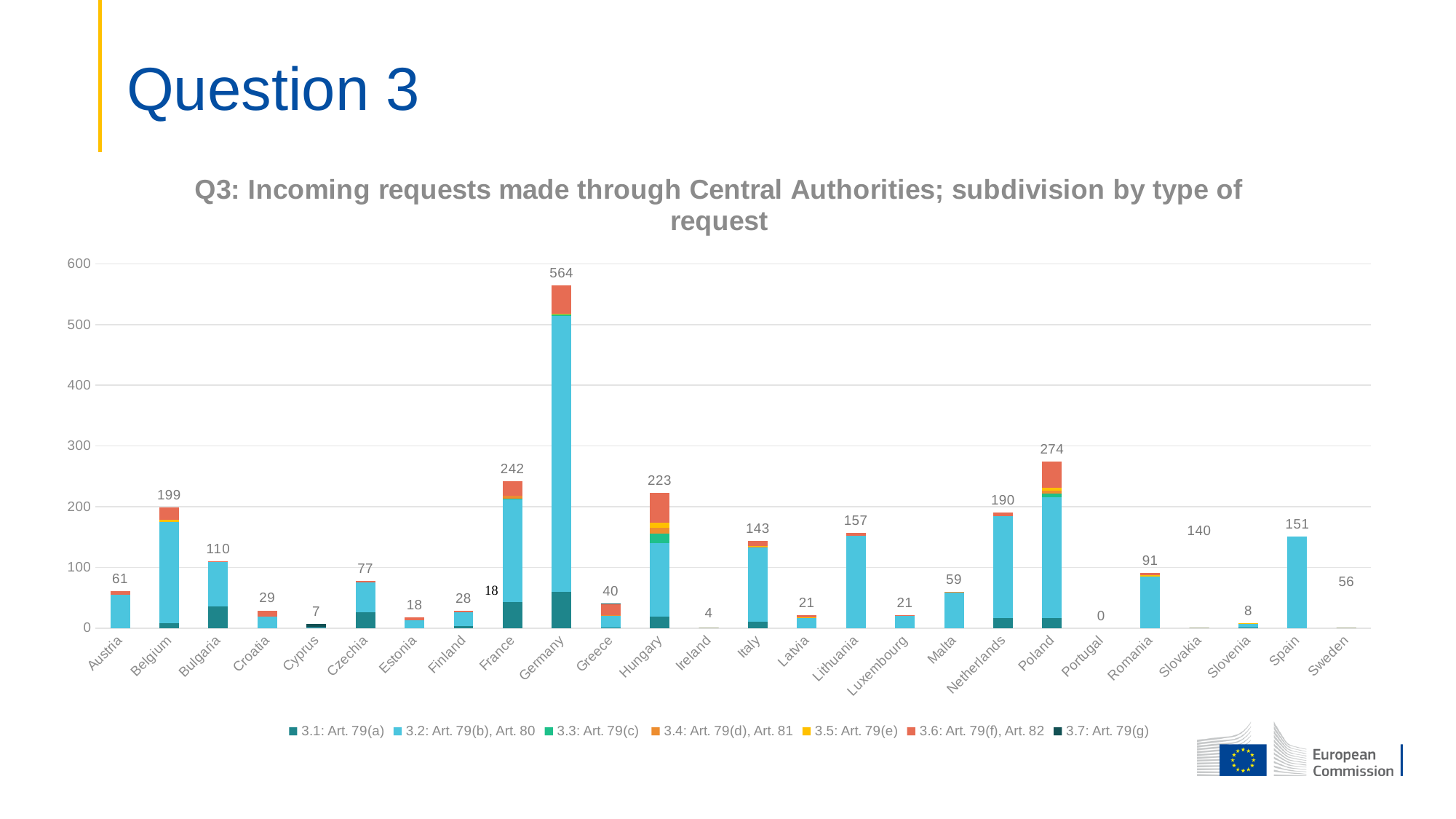
What is the title of the chart? Q3: Incoming requests made through Central Authorities; subdivision by type of request What kind of chart is shown on the slide? Stacked bar chart What is the total number of incoming requests for Germany? 564 Is the total for Italy greater or less than 100? greater Which country has the highest total of incoming requests? Germany Which country has the lowest total of incoming requests? Portugal What is the difference between the totals for Poland and France? 32 What is the total number of incoming requests for Poland? 274 How many series does the legend list? 7 What is the total number of incoming requests for Belgium? 199 How many countries are shown on the x axis? 26 Which has a larger total, Hungary or the Netherlands? Hungary